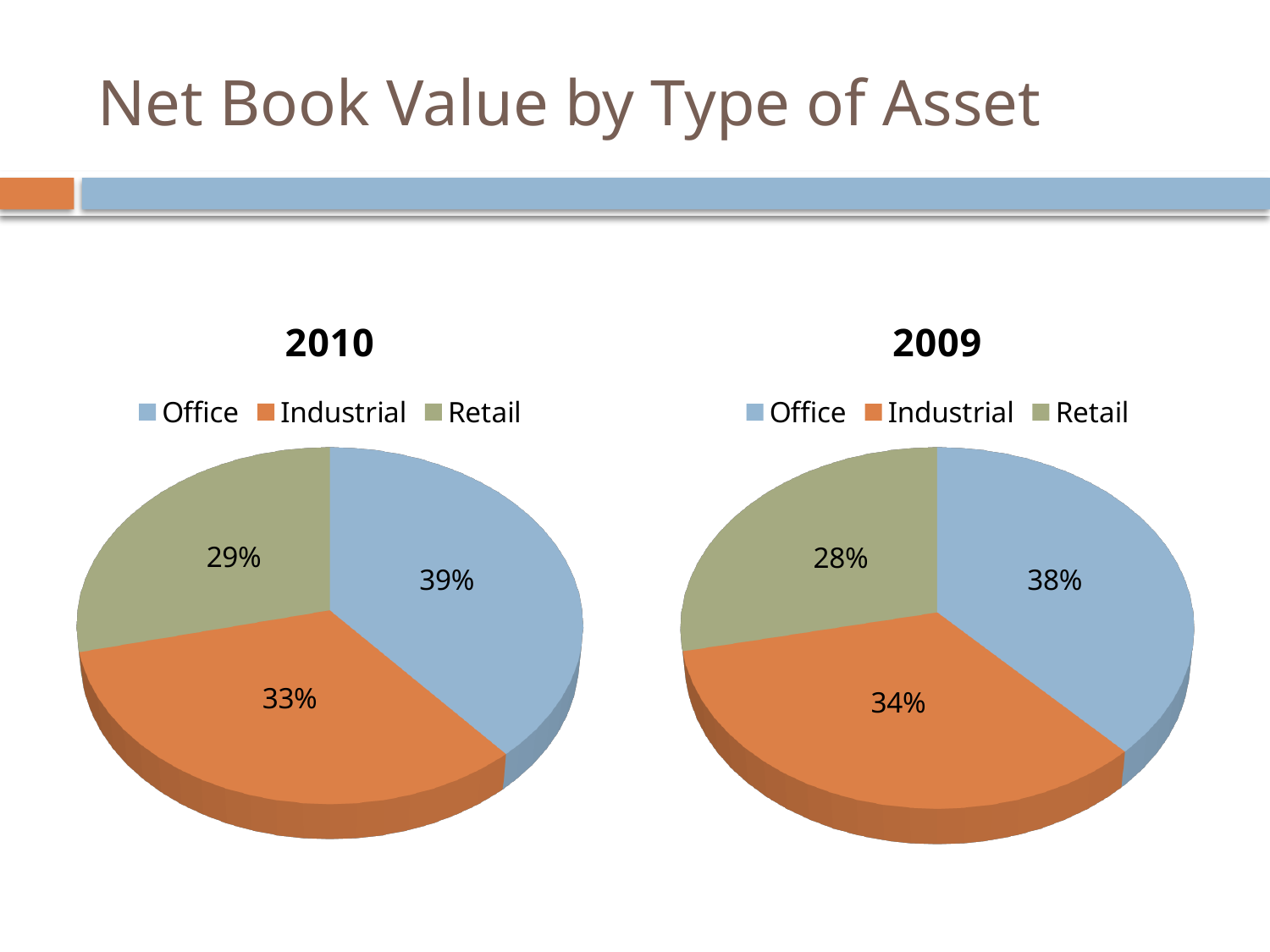
In the 2010 pie chart, what share does Retail have? 29% How many slices does the 2010 pie chart have? 3 In the 2010 pie chart, what is the difference between the Office share and the Retail share? 10% In the 2009 pie chart, what is the difference between the Industrial share and the Retail share? 6% In the 2010 pie chart, what share does Office have? 39% In the 2010 pie chart, which asset type has the smallest share? Retail In the 2009 pie chart, which asset type has the largest share? Office What type of chart is the 2010 chart? Pie chart In the 2009 pie chart, what share does Industrial have? 34% What colour represents Industrial in the 2010 pie chart? Orange In the 2009 pie chart, which is larger, the Office share or the Industrial share? Office How many entries does the legend of the 2009 chart list? 3